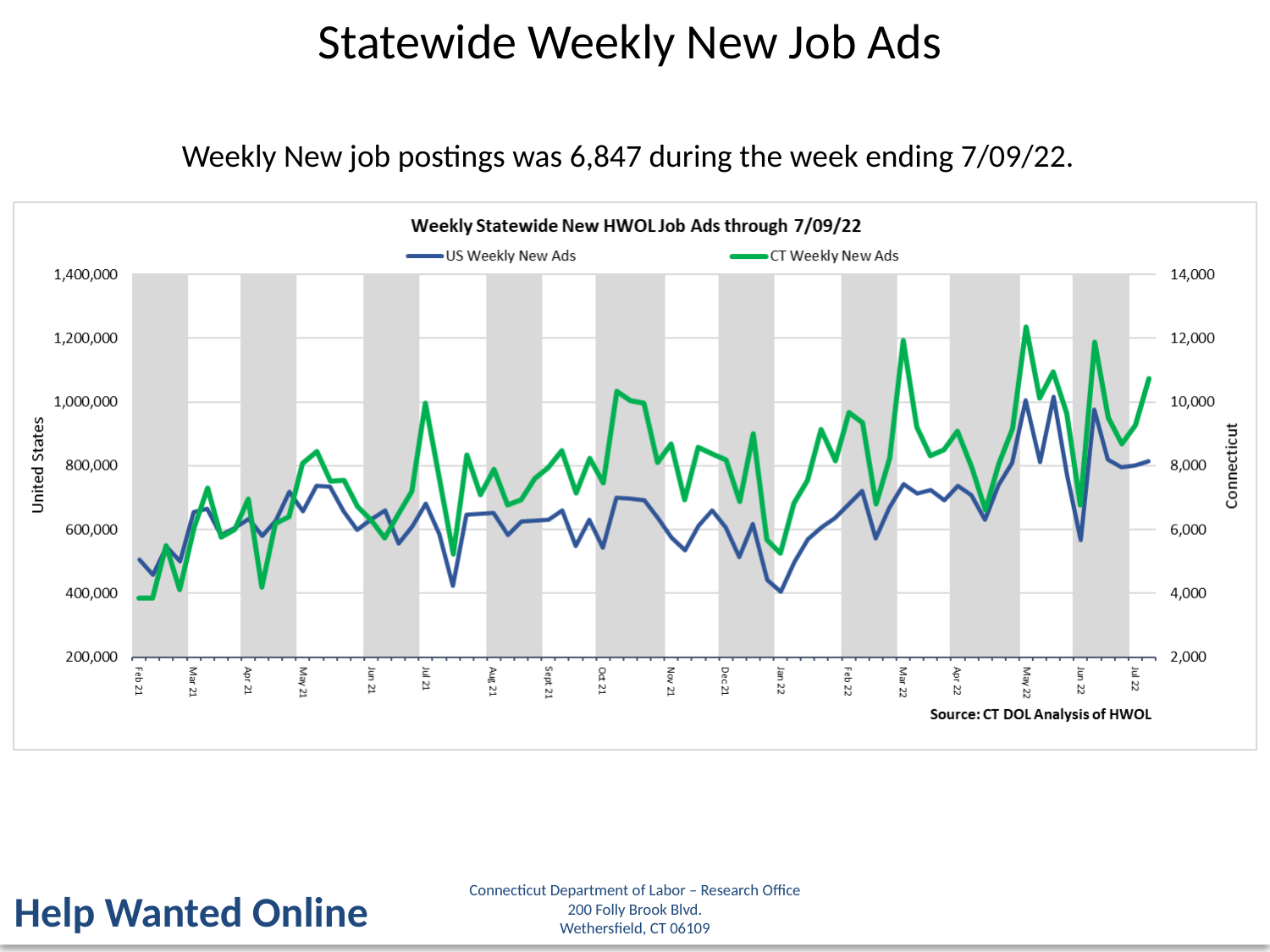
What are the two series named in the chart legend? US Weekly New Ads and CT Weekly New Ads Around which month does the CT Weekly New Ads series reach its highest point? May 22 What kind of chart is shown on the slide? Line chart Which is larger for CT Weekly New Ads: the value at Mar 22 or the value at Jan 22? Mar 22 Is the value of US Weekly New Ads at Jan 22 greater or less than 600,000? less Is the value of CT Weekly New Ads at Feb 21 greater or less than 6,000? less Overall, do CT Weekly New Ads rise or fall from Feb 21 to Jul 22? Rise Is the peak value of CT Weekly New Ads around May 22 greater or less than 12,000? greater How many series does the chart legend list? 2 Around which month does the CT Weekly New Ads series reach its lowest point? Feb 21 What is the title of the chart? Weekly Statewide New HWOL Job Ads through 7/09/22